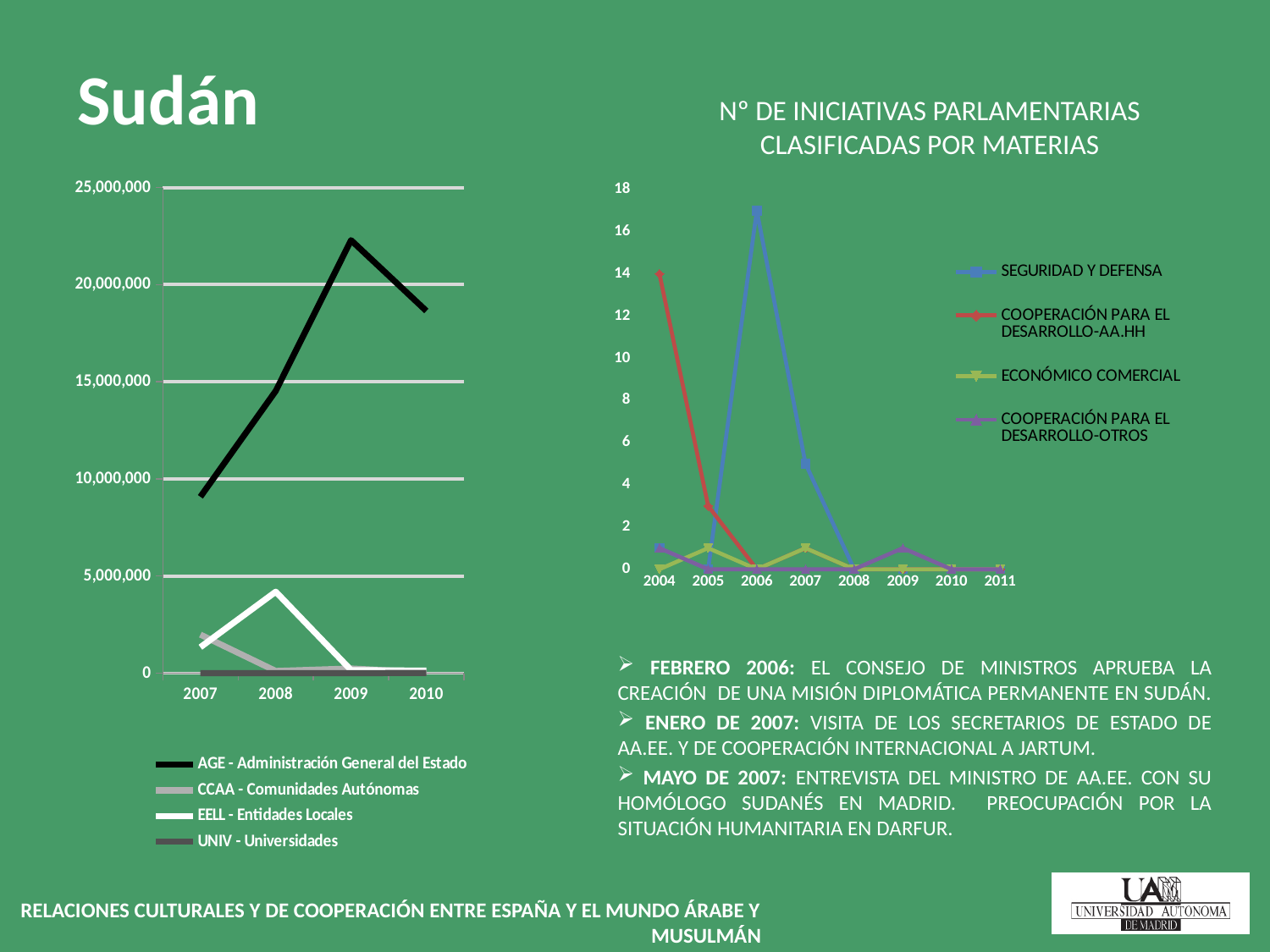
In the left chart, is the value for AGE - Administración General del Estado in 2009 greater or less than 20,000,000? greater In the left chart, is the value for EELL - Entidades Locales in 2008 greater or less than 5,000,000? less In the right chart (Nº DE INICIATIVAS PARLAMENTARIAS), does the COOPERACIÓN PARA EL DESARROLLO-AA.HH series rise or fall from 2004 to 2006? fall How many years are shown on the x axis of the right chart (Nº DE INICIATIVAS PARLAMENTARIAS)? 8 In the left chart, which series has the highest value in 2009? AGE - Administración General del Estado In the right chart (Nº DE INICIATIVAS PARLAMENTARIAS), in which year does SEGURIDAD Y DEFENSA reach its highest value? 2006 How many series does the legend of the left chart list? 4 In the right chart (Nº DE INICIATIVAS PARLAMENTARIAS), is the value for SEGURIDAD Y DEFENSA in 2006 greater or less than 16? greater In the right chart (Nº DE INICIATIVAS PARLAMENTARIAS), what is the value for SEGURIDAD Y DEFENSA in 2008? 0 What is the title of the chart on the right of the slide? Nº DE INICIATIVAS PARLAMENTARIAS CLASIFICADAS POR MATERIAS In the right chart (Nº DE INICIATIVAS PARLAMENTARIAS), what is the value for COOPERACIÓN PARA EL DESARROLLO-AA.HH in 2004? 14 What kind of chart is the chart on the left of the slide? line chart